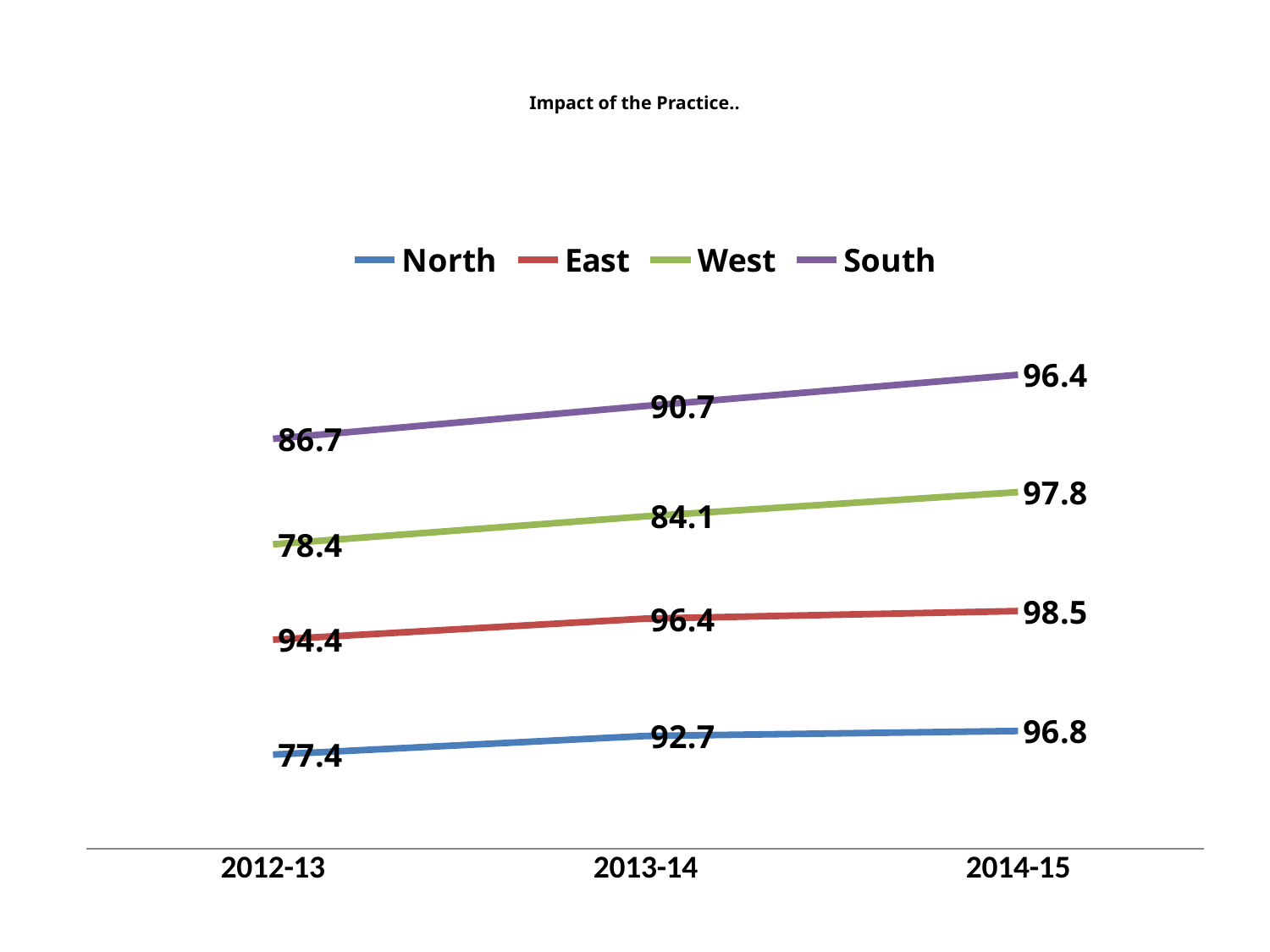
What is the value for North in 2012-13? 77.4 What kind of chart is shown on the slide? Line chart How many series does the legend list? 4 Which is larger in 2013-14, the value for East or the value for South? East Which series has the lowest labelled value in 2012-13? North What is the value for West in 2013-14? 84.1 Do the values for West rise or fall from 2012-13 to 2014-15? Rise By how much did the South value increase from 2012-13 to 2014-15? 9.7 What is the value for South in 2012-13? 86.7 What is the value for East in 2014-15? 98.5 Which series has the highest labelled value in 2014-15? East What is the value for North in 2014-15? 96.8